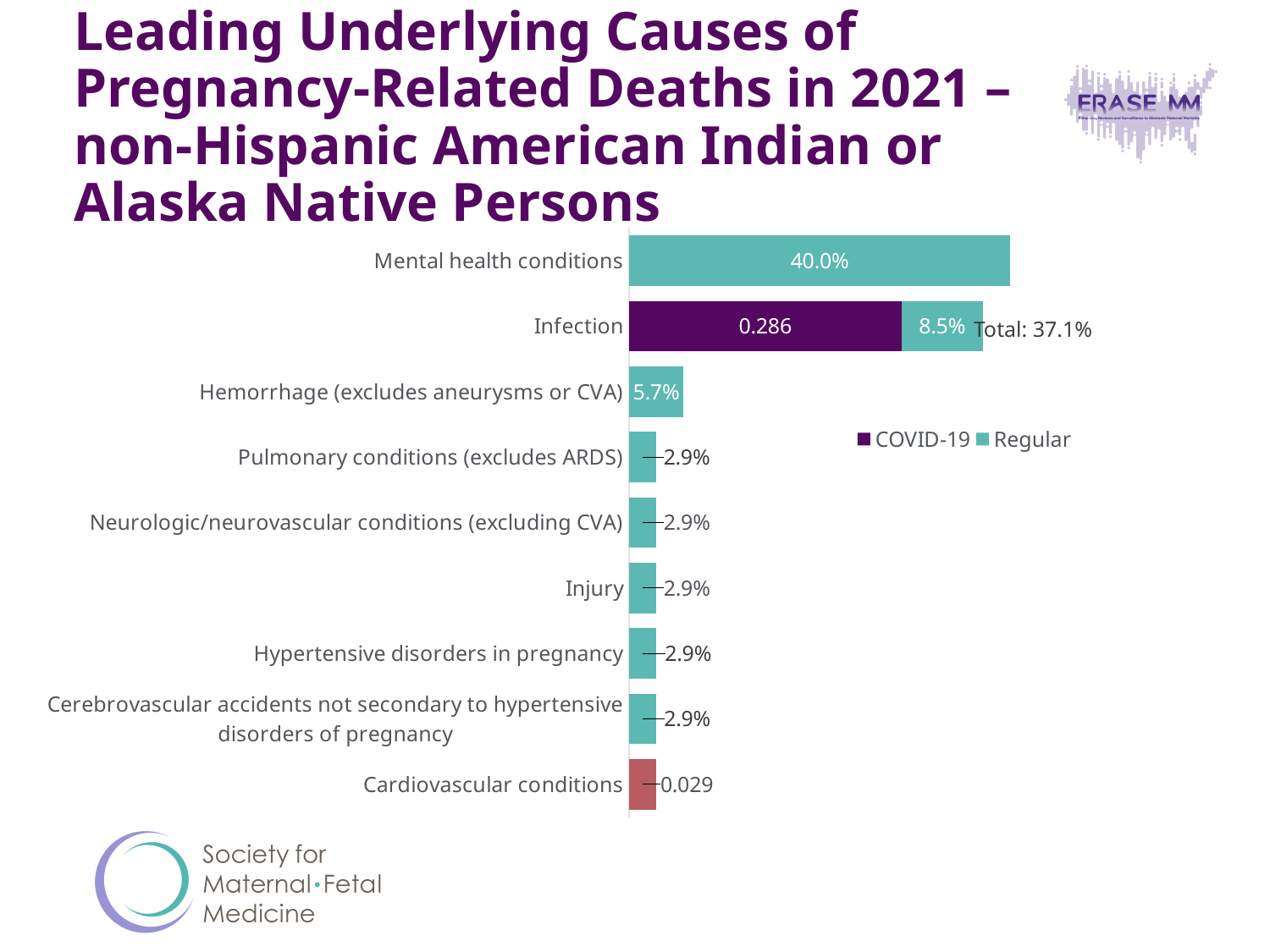
How many categories are shown on the chart? 9 What are the two series named in the legend? COVID-19 and Regular What is the Regular value shown for Infection? 8.5% How many series does the legend list? 2 What is the value shown for Hemorrhage (excludes aneurysms or CVA)? 5.7% What is the COVID-19 value shown for Infection? 0.286 Which is larger, the value for Mental health conditions or the value for Hemorrhage (excludes aneurysms or CVA)? Mental health conditions What is the value shown for Cardiovascular conditions? 0.029 What is the value shown for Mental health conditions? 40.0% What kind of chart is shown on the slide? Bar chart Which category has the highest value? Mental health conditions What total is printed next to the Infection bar? Total: 37.1%